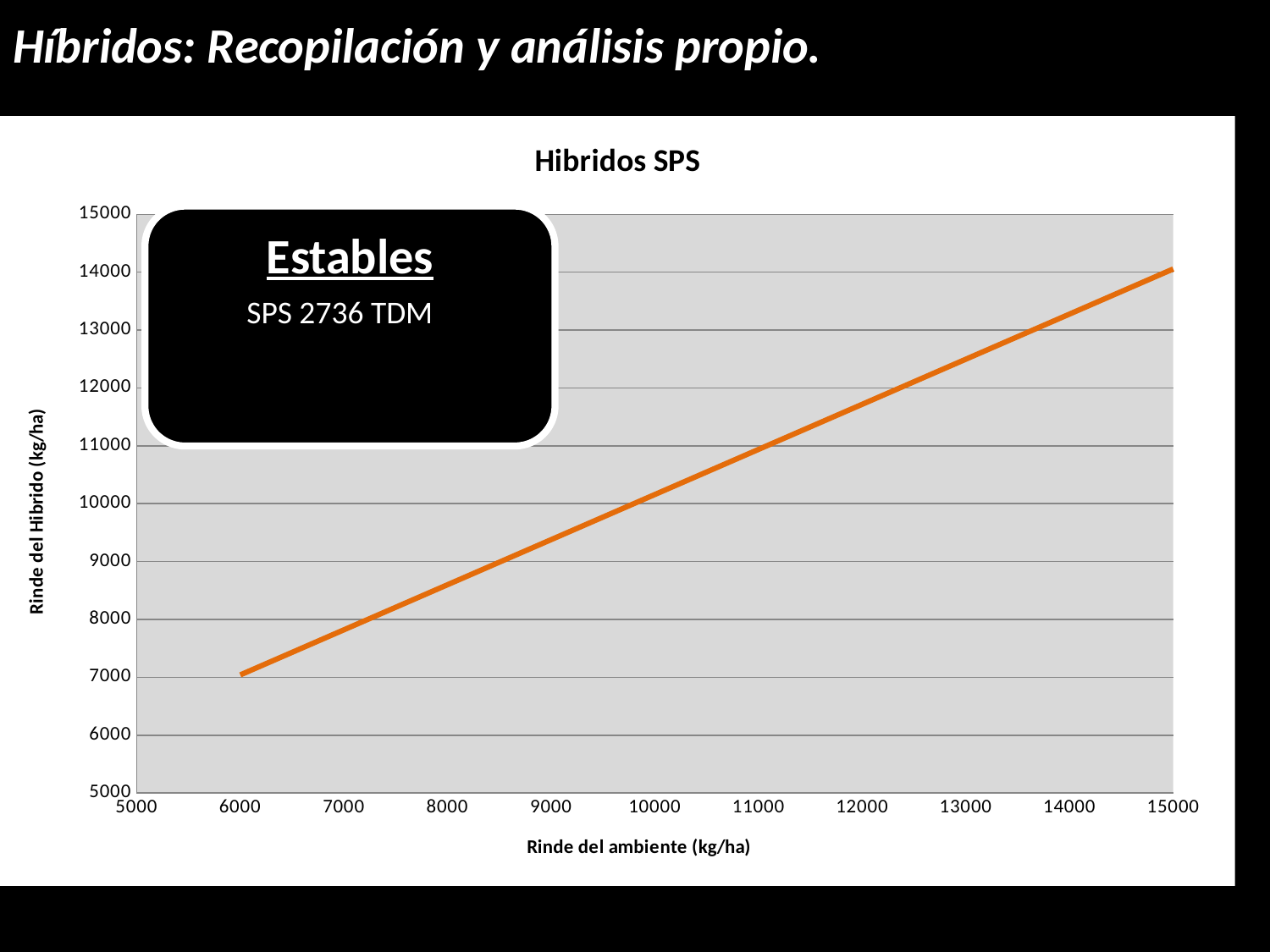
In the 'Hibridos SPS' chart, is the hybrid yield at an environment yield of 12000 kg/ha greater or less than 12000? less Which hybrid is named in the 'Estables' box on the chart? SPS 2736 TDM In the 'Hibridos SPS' chart, is the hybrid yield at an environment yield of 8000 kg/ha greater or less than 8000? greater Does the line in the 'Hibridos SPS' chart rise or fall as 'Rinde del ambiente (kg/ha)' increases? rise In the 'Hibridos SPS' chart, is the hybrid yield at an environment yield of 15000 kg/ha greater or less than 15000? less What is the title of the chart on the slide? Hibridos SPS In the 'Hibridos SPS' chart, is the hybrid yield higher at an environment yield of 14000 kg/ha or at 7000 kg/ha? 14000 kg/ha What kind of chart is shown on the slide? line chart